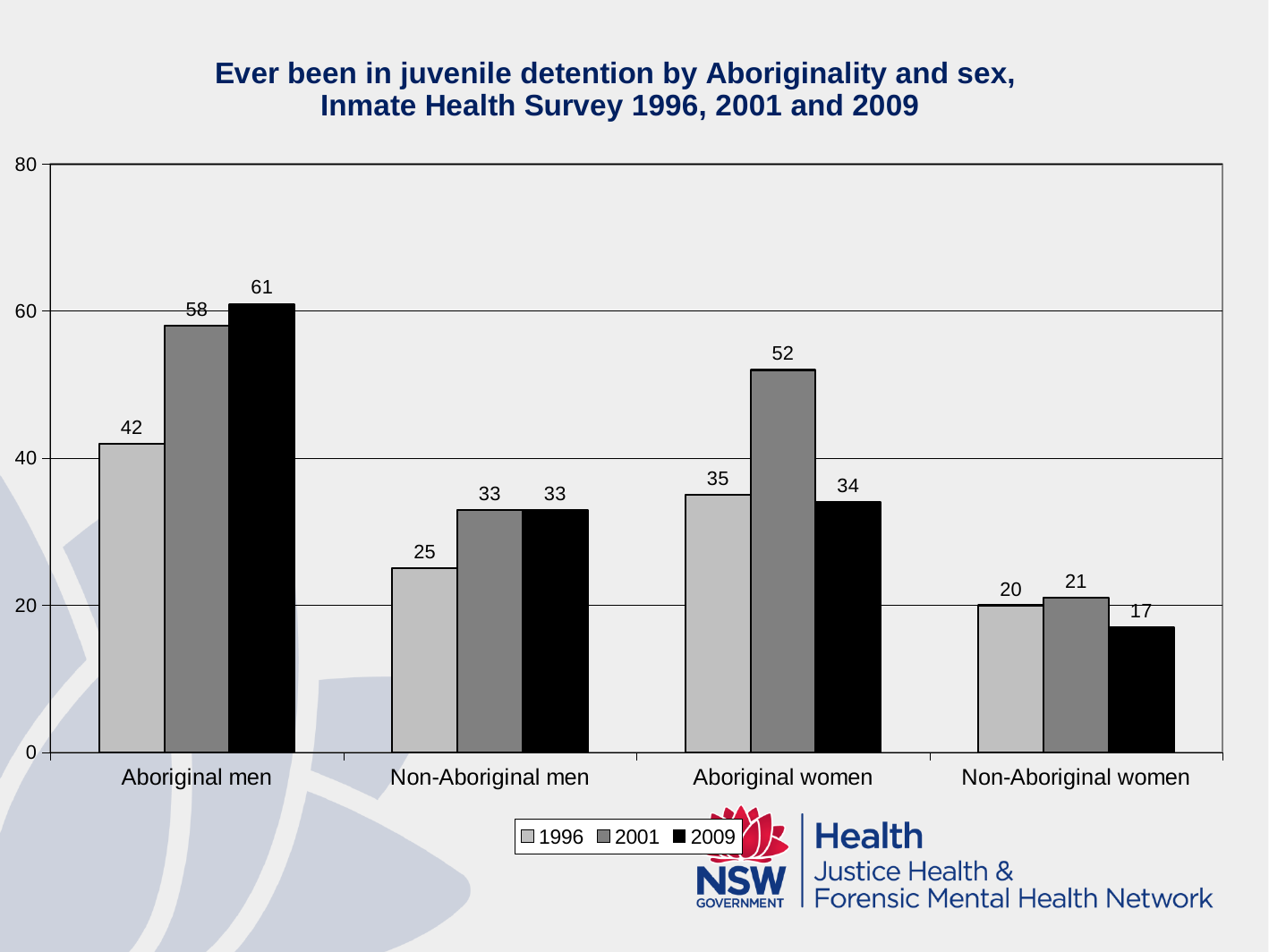
How many categories are shown on the x axis? 4 What is the value for Aboriginal women in 2001? 52 What kind of chart is shown on the slide? Bar chart What is the value for Aboriginal men in 2009? 61 What is the value for Non-Aboriginal women in 1996? 20 Which series is shown in black in the legend? 2009 Do the values for Aboriginal men rise or fall from 1996 to 2009? Rise Which category has the lowest value in 2009? Non-Aboriginal women How many series does the legend list? 3 Which category has the highest value in 2001? Aboriginal men What is the difference between the 2009 and 1996 values for Aboriginal men? 19 Which is larger for Aboriginal women: the 2001 value or the 2009 value? 2001